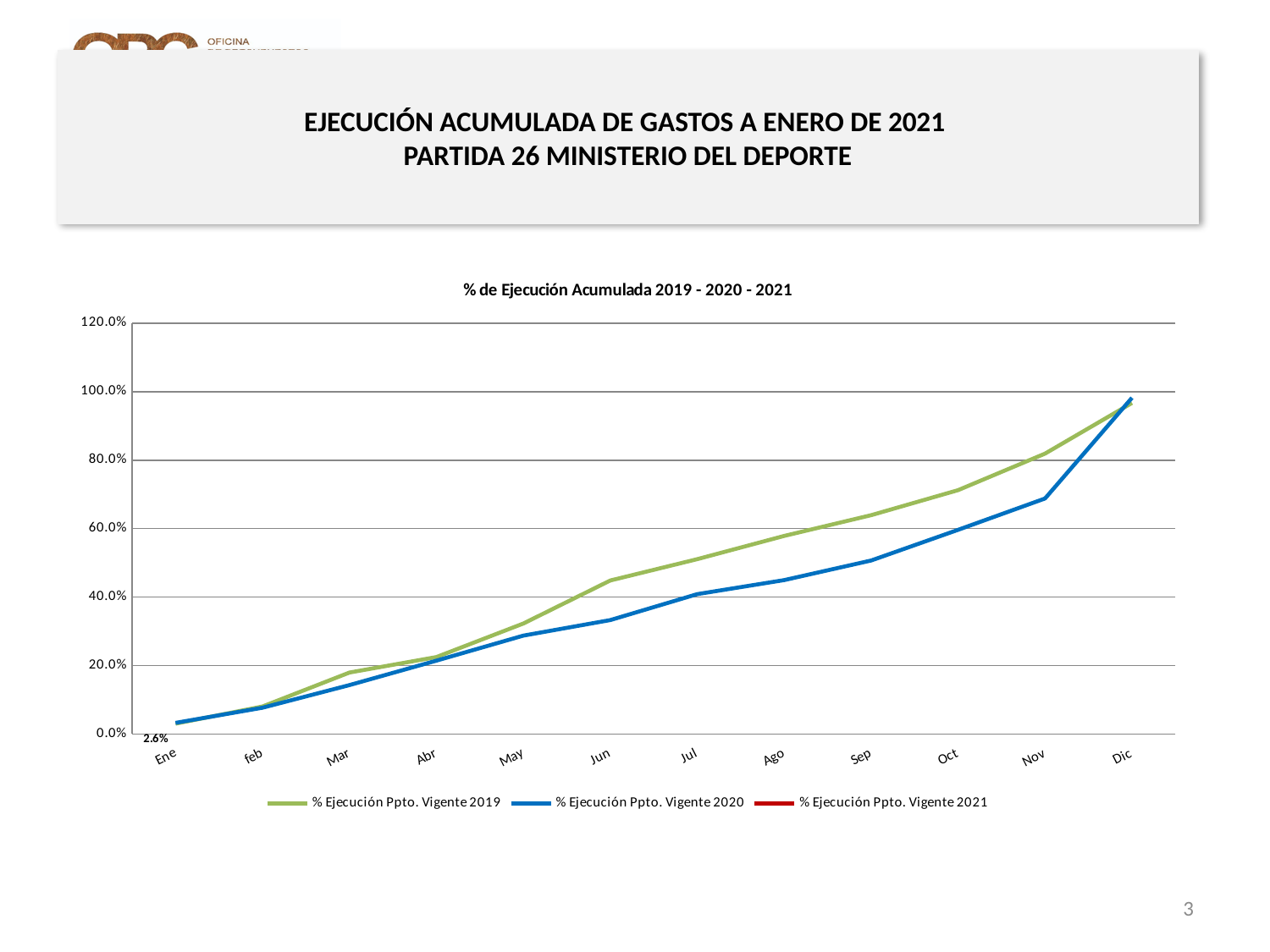
In which month does % Ejecución Ppto. Vigente 2020 reach its highest value? Dic What is the title of the chart? % de Ejecución Acumulada 2019 - 2020 - 2021 At Nov, which series has the higher value, % Ejecución Ppto. Vigente 2019 or % Ejecución Ppto. Vigente 2020? % Ejecución Ppto. Vigente 2019 How many months are shown along the x axis? 12 Do the values for % Ejecución Ppto. Vigente 2019 rise or fall from Ene to Dic? rise Is the value for % Ejecución Ppto. Vigente 2019 at Jun greater or less than 40.0%? greater Is the value for % Ejecución Ppto. Vigente 2019 at Oct greater or less than 60.0%? greater Is the value for % Ejecución Ppto. Vigente 2020 at Jun greater or less than 40.0%? less How many series does the legend list? 3 What kind of chart is shown on the slide? line chart What data label is printed at Ene? 2.6%